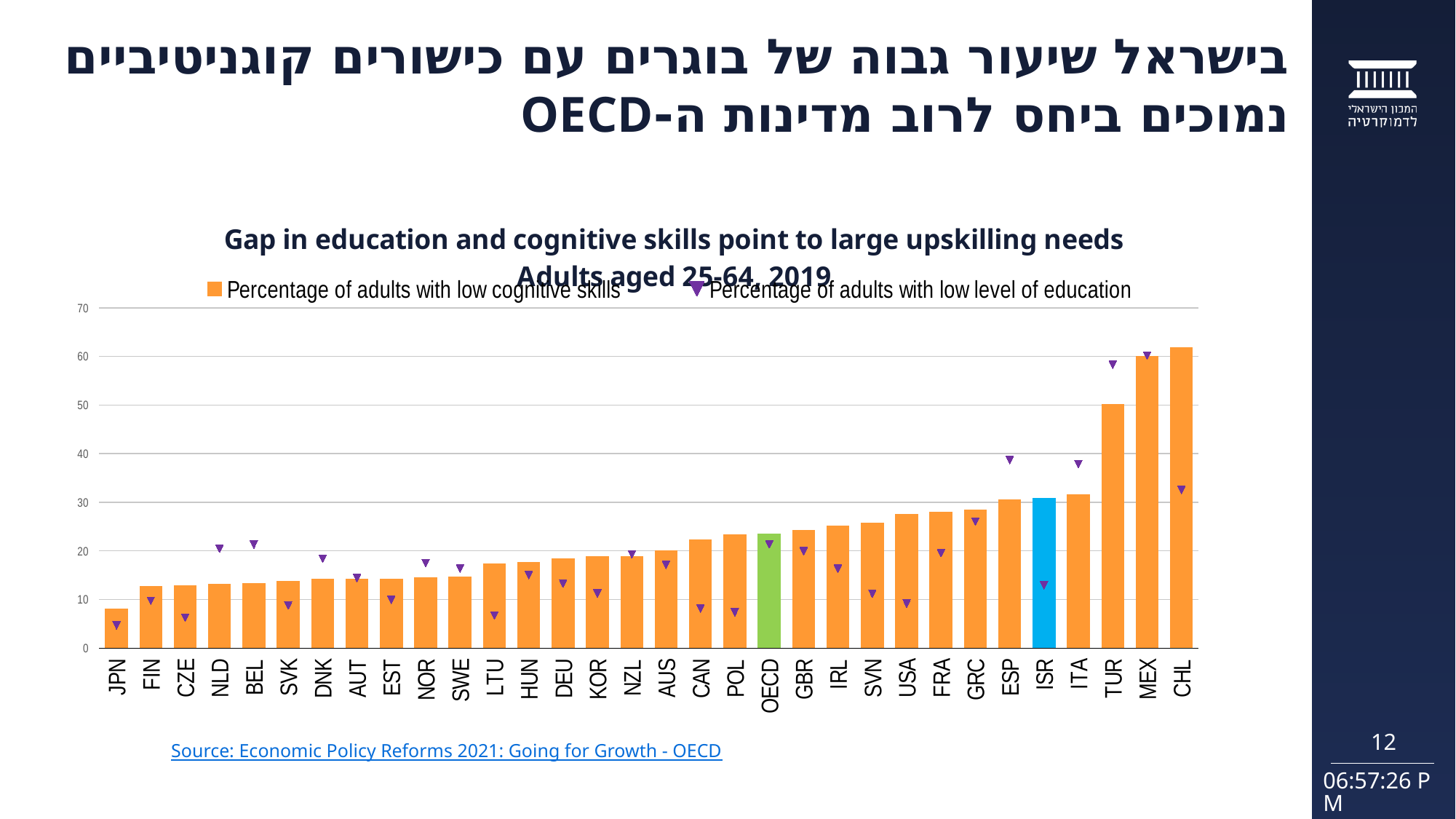
Is the percentage of adults with low cognitive skills for CHL greater or less than 60? greater Is the percentage of adults with low level of education for TUR greater or less than 50? greater Do the bars for percentage of adults with low cognitive skills rise or fall from left to right along the x axis? rise Which category has the highest percentage of adults with low cognitive skills? CHL Which has a higher percentage of adults with low cognitive skills, ISR or TUR? TUR Which category has the lowest percentage of adults with low cognitive skills? JPN Is the percentage of adults with low cognitive skills for JPN greater or less than 10? less How many series does the legend list? 2 What colour is the bar for ISR? blue What kind of chart is shown on the slide? bar chart How many countries/categories are shown on the x axis? 32